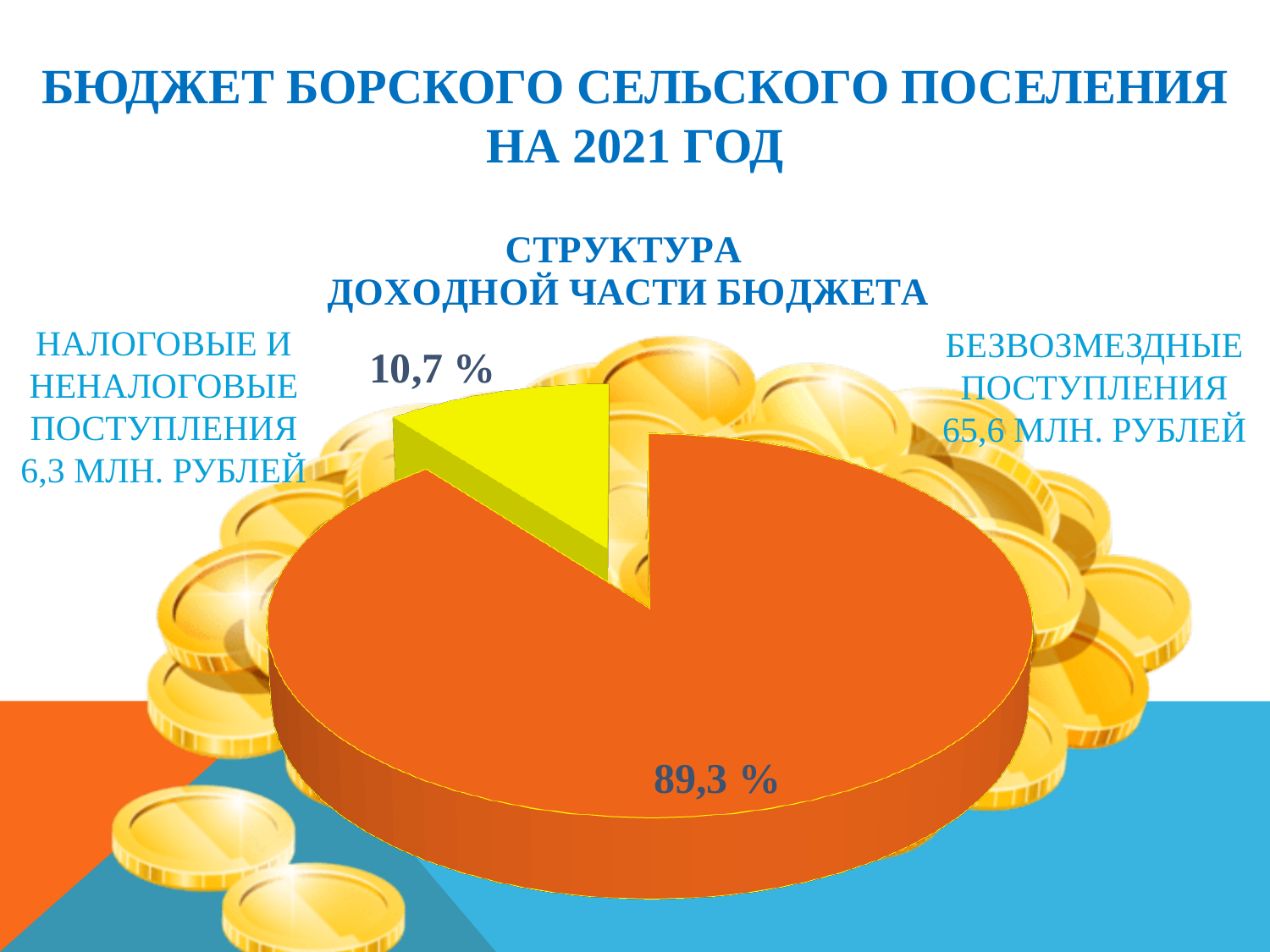
How many slices does the pie chart have? 2 Which is larger: the share for БЕЗВОЗМЕЗДНЫЕ ПОСТУПЛЕНИЯ or the share for НАЛОГОВЫЕ И НЕНАЛОГОВЫЕ ПОСТУПЛЕНИЯ? БЕЗВОЗМЕЗДНЫЕ ПОСТУПЛЕНИЯ Which category has the smallest share of the pie? НАЛОГОВЫЕ И НЕНАЛОГОВЫЕ ПОСТУПЛЕНИЯ Which category has the largest share of the pie? БЕЗВОЗМЕЗДНЫЕ ПОСТУПЛЕНИЯ What is the difference in percentage points between the 89,3 % slice and the 10,7 % slice? 78,6 What share of the pie is labelled for БЕЗВОЗМЕЗДНЫЕ ПОСТУПЛЕНИЯ? 89,3 % What amount in million rubles is shown for БЕЗВОЗМЕЗДНЫЕ ПОСТУПЛЕНИЯ? 65,6 МЛН. РУБЛЕЙ What amount in million rubles is shown for НАЛОГОВЫЕ И НЕНАЛОГОВЫЕ ПОСТУПЛЕНИЯ? 6,3 МЛН. РУБЛЕЙ What colour is the slice representing БЕЗВОЗМЕЗДНЫЕ ПОСТУПЛЕНИЯ? Orange What share of the pie is labelled for НАЛОГОВЫЕ И НЕНАЛОГОВЫЕ ПОСТУПЛЕНИЯ? 10,7 % What kind of chart is shown on the slide? Pie chart What is the title of the chart on the slide? СТРУКТУРА ДОХОДНОЙ ЧАСТИ БЮДЖЕТА